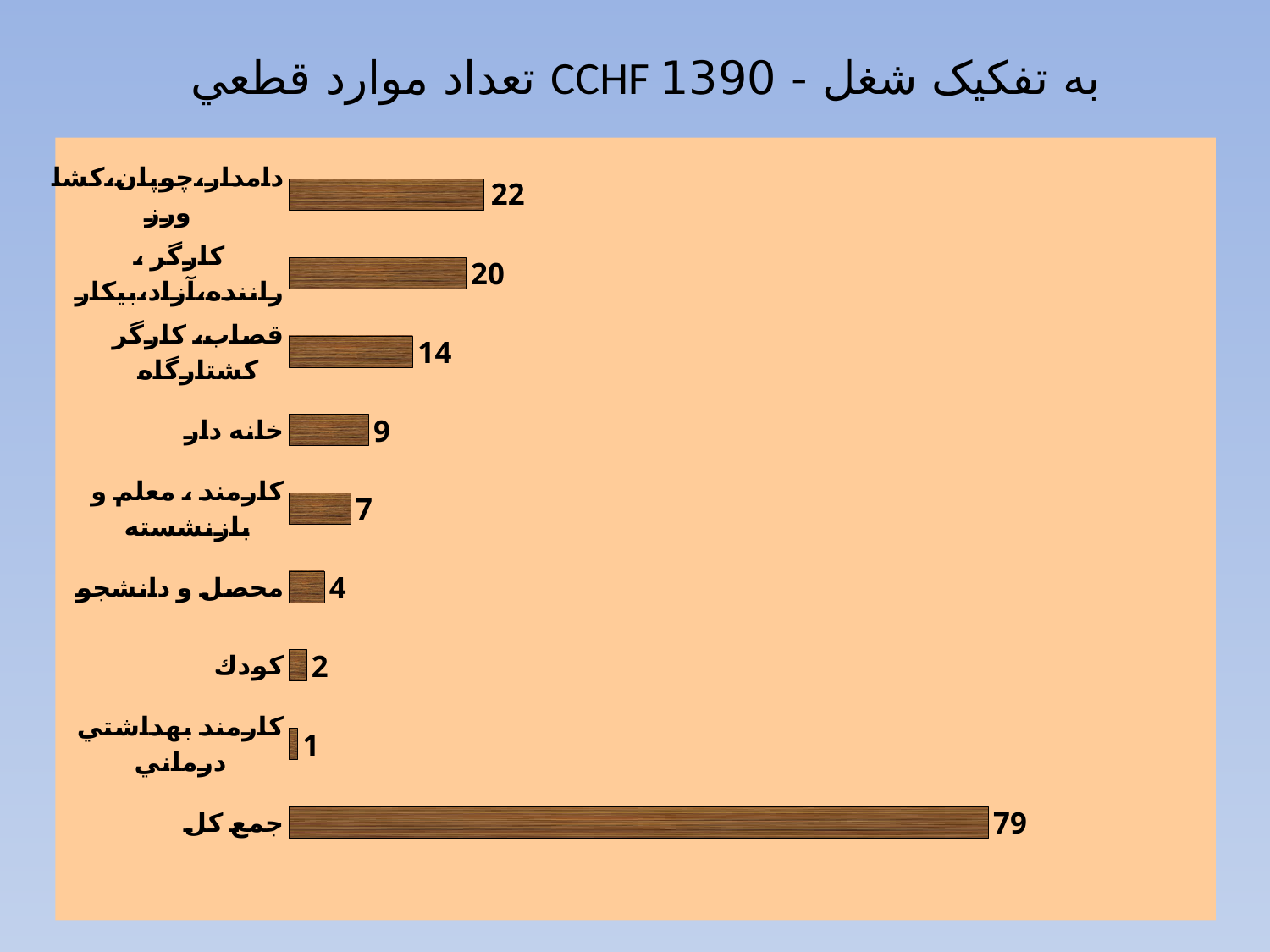
Excluding the total bar "جمع کل", which occupation category has the highest value? دامدار،چوپان،کشاورز What is the value shown for "جمع کل" (total)? 79 What is the difference between the values for "دامدار،چوپان،کشاورز" (22) and "کارگر ، راننده،آزاد،بیکار" (20)? 2 What kind of chart is shown on the slide? bar chart What is the value for the category "خانه دار" (housewife)? 9 How many bars are plotted on the chart, including the total bar? 9 What is the value for the category "کودک" (child)? 2 What is the value for the category "قصاب، کارگر کشتارگاه" (butcher, slaughterhouse worker)? 14 What is the difference between the value for "قصاب، کارگر کشتارگاه" and the value for "خانه دار"? 5 Which is larger: the value for "کارمند ، معلم و بازنشسته" or the value for "محصل و دانشجو"? کارمند ، معلم و بازنشسته Which category has the lowest value? کارمند بهداشتي درماني What year is mentioned in the chart title? 1390